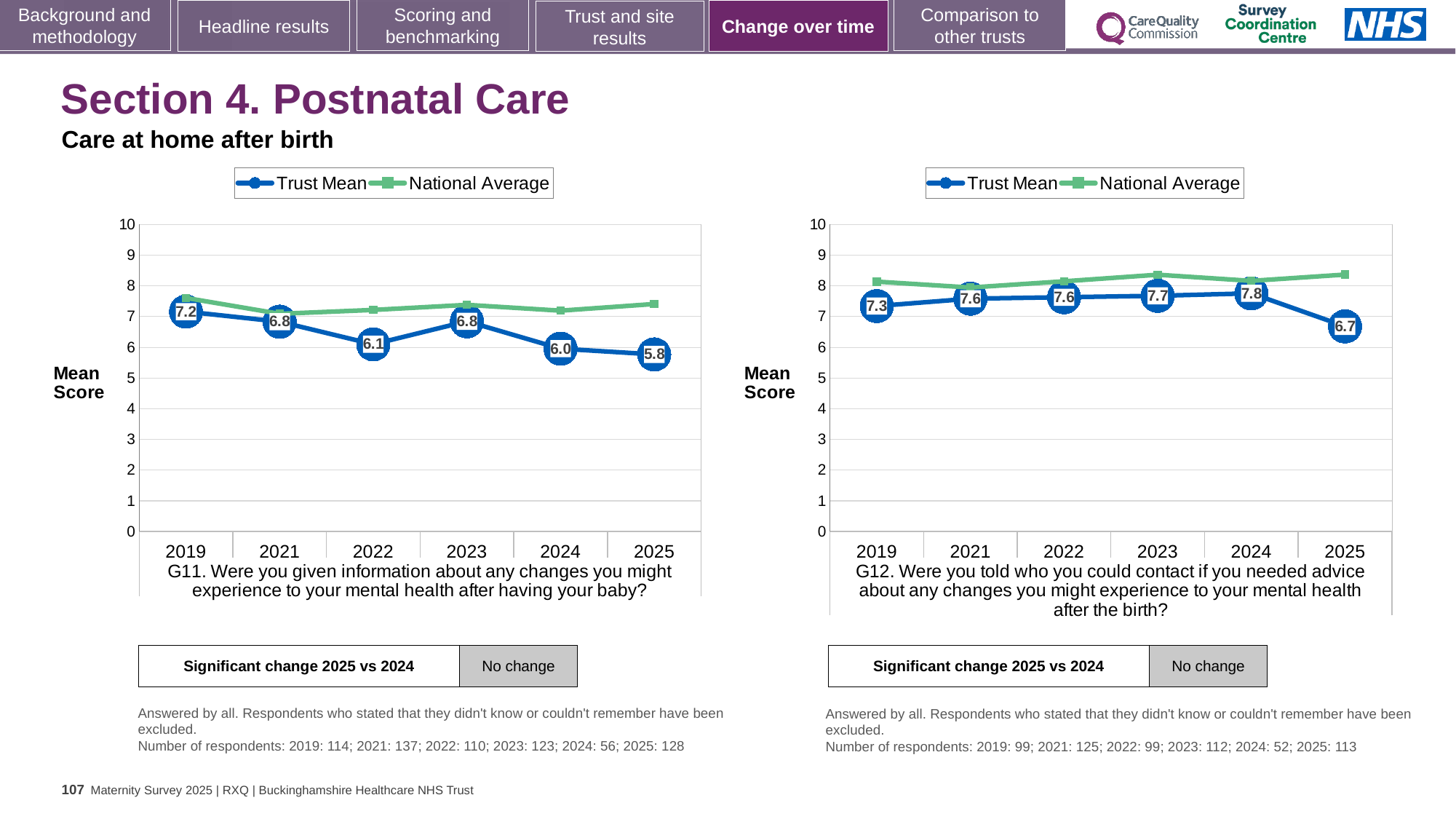
On the G12 chart (right), which year has the highest Trust Mean score? 2024 On the G11 chart (left), what is the Trust Mean score for 2019? 7.2 On the G11 chart (left), which year has the lowest Trust Mean score? 2025 On the G11 chart (left), what is the Trust Mean score for 2025? 5.8 How many series does the legend of the G11 chart (left) list? 2 How many years are plotted on the G12 chart (right)? 6 On the G11 chart (left), what is the difference between the Trust Mean scores for 2019 and 2025? 1.4 What type of chart is the G11 chart (left)? Line chart On the G12 chart (right), which is larger, the Trust Mean for 2023 or the Trust Mean for 2025? 2023 On the G12 chart (right), what is the difference between the Trust Mean scores for 2024 and 2025? 1.1 On the G12 chart (right), what is the Trust Mean score for 2024? 7.8 On the G11 chart (left), is the National Average for 2025 greater or less than 7? greater